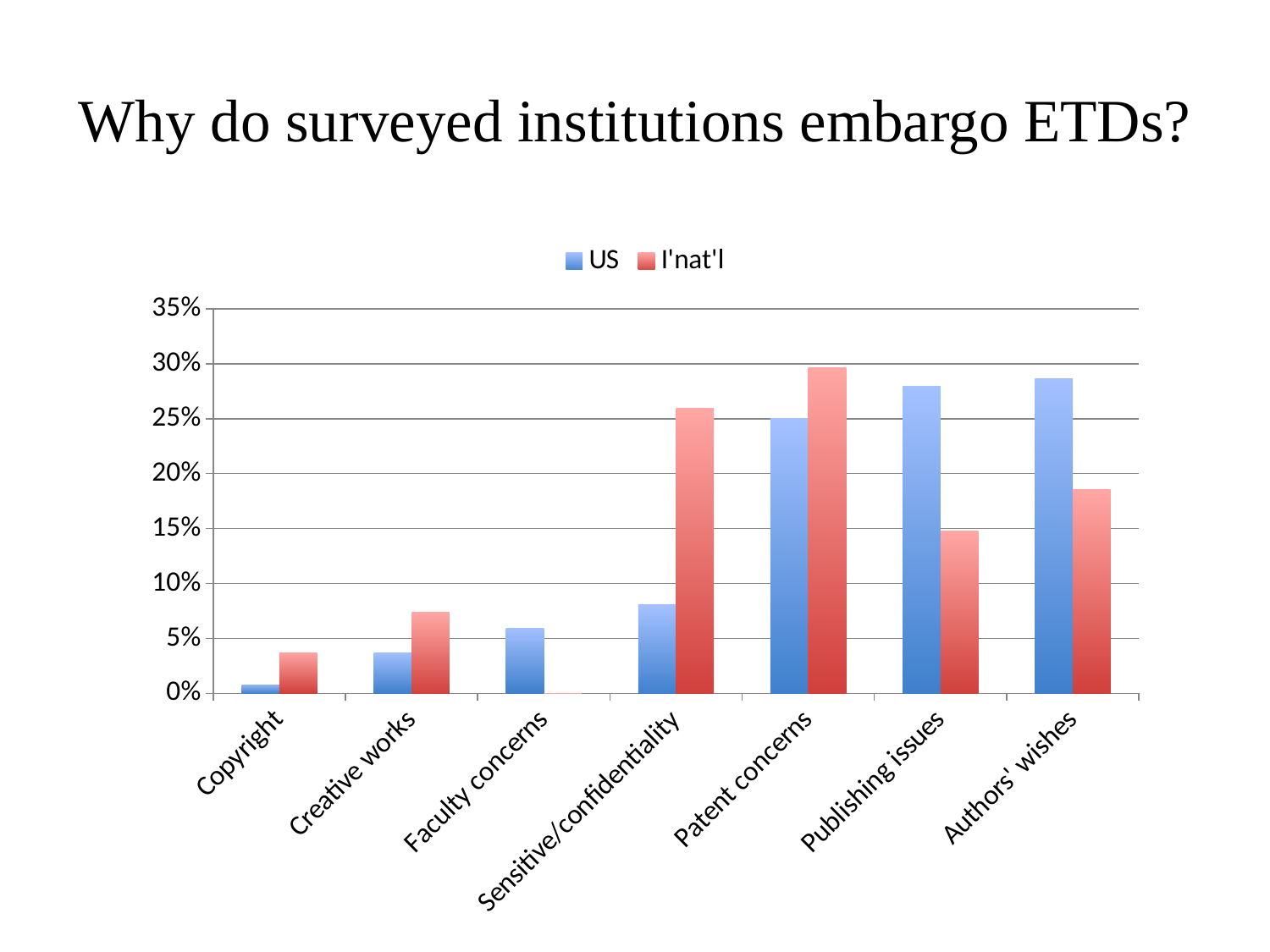
Which category has the lowest US value? Copyright How many series does the legend list? 2 Is the US value for Publishing issues greater or less than 25%? greater For Sensitive/confidentiality, which series has the larger value, US or I'nat'l? I'nat'l Is the I'nat'l value for Sensitive/confidentiality greater or less than 25%? greater How many categories are shown on the x axis? 7 Which category has the lowest I'nat'l value? Faculty concerns For Publishing issues, which series has the larger value, US or I'nat'l? US Is the I'nat'l value for Authors' wishes greater or less than 20%? less Which category has the highest I'nat'l value? Patent concerns What is the title of the slide? Why do surveyed institutions embargo ETDs? What kind of chart is shown on the slide? bar chart